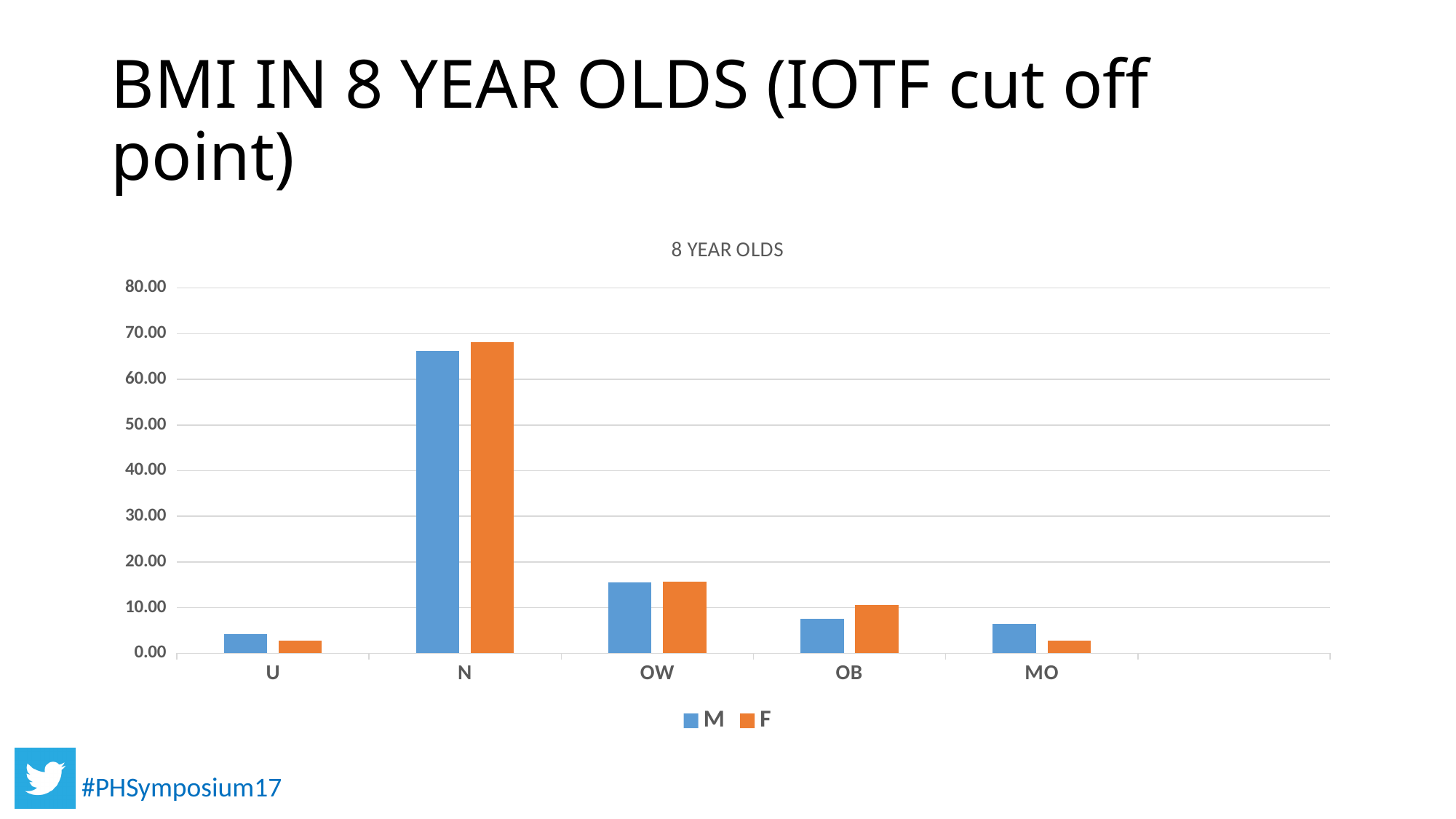
Is the value for M in category OB greater or less than 10? less Is the value for M in category N greater or less than 60? greater What is the title shown above the chart? 8 YEAR OLDS How many categories are shown on the x axis of the chart? 5 In category MO, which series has the larger value, M or F? M What kind of chart is shown on the slide? bar chart Which category has the highest value for the M series? N Which category has the highest value for the F series? N How many series does the chart's legend list? 2 In category N, which series has the larger value, M or F? F Which category has the lowest value for the M series? U Is the value for F in category N greater or less than 70? less